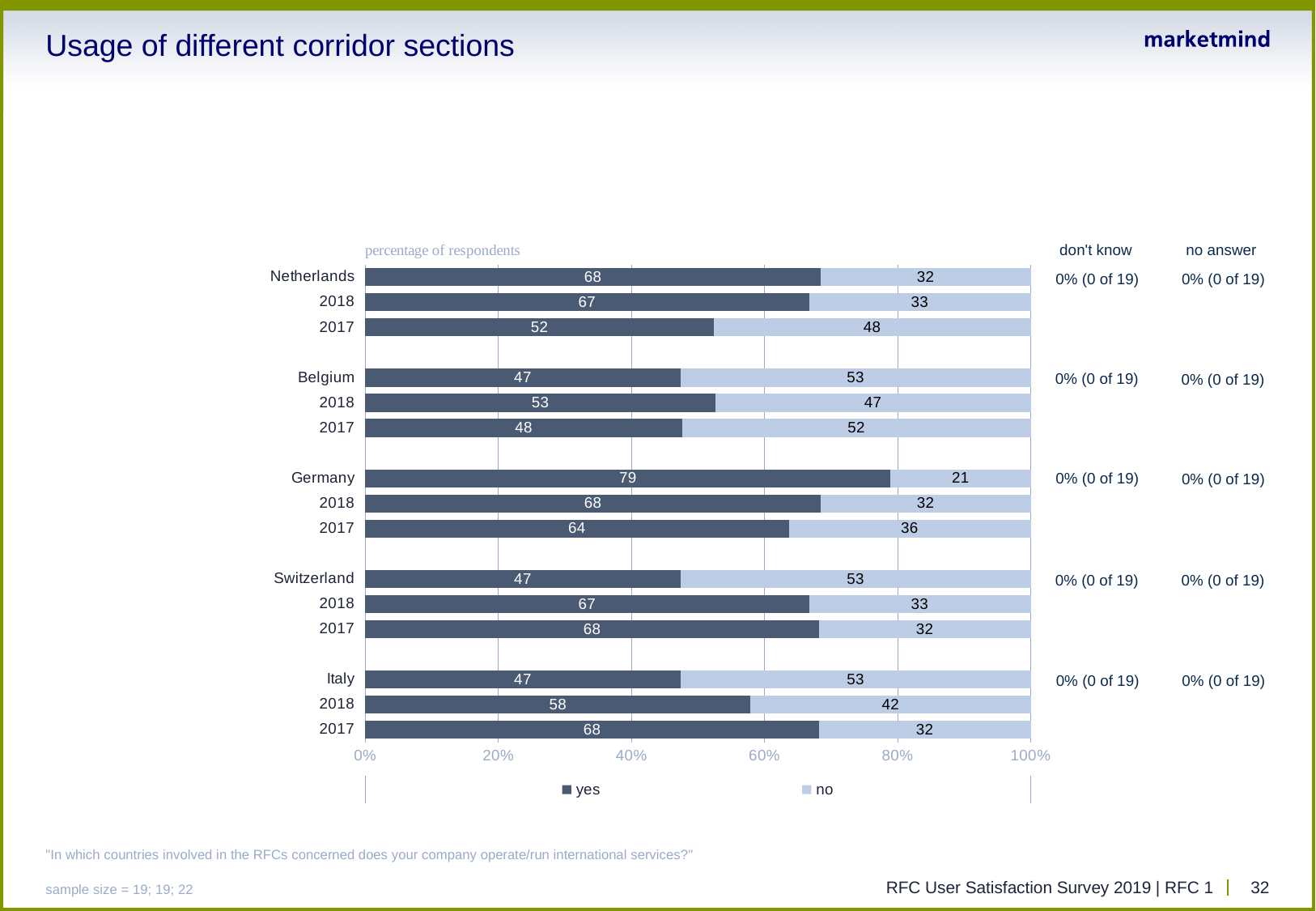
What is the total of the "yes" and "no" values for Switzerland in 2018? 100 How many series does the legend list? 2 Which is larger: the "yes" value for Italy in 2017 or the "yes" value for Italy in 2018? Italy in 2017 Among the top (current) rows for each country, which country has the lowest "yes" value? Belgium, Switzerland and Italy (tied at 47) Among the top (current) rows for each country, which country has the highest "yes" value? Germany What is the "don't know" value shown for Belgium? 0% (0 of 19) What is the difference between the "yes" value for Germany (top row) and the "yes" value for Belgium (top row)? 32 How many countries are shown in the chart? 5 What type of chart is shown on the slide? stacked bar chart What percentage of respondents answered "yes" for Germany in the top (current) row? 79 What is the "no" value for Italy in 2018? 42 What is the "yes" value for the Netherlands in 2017? 52